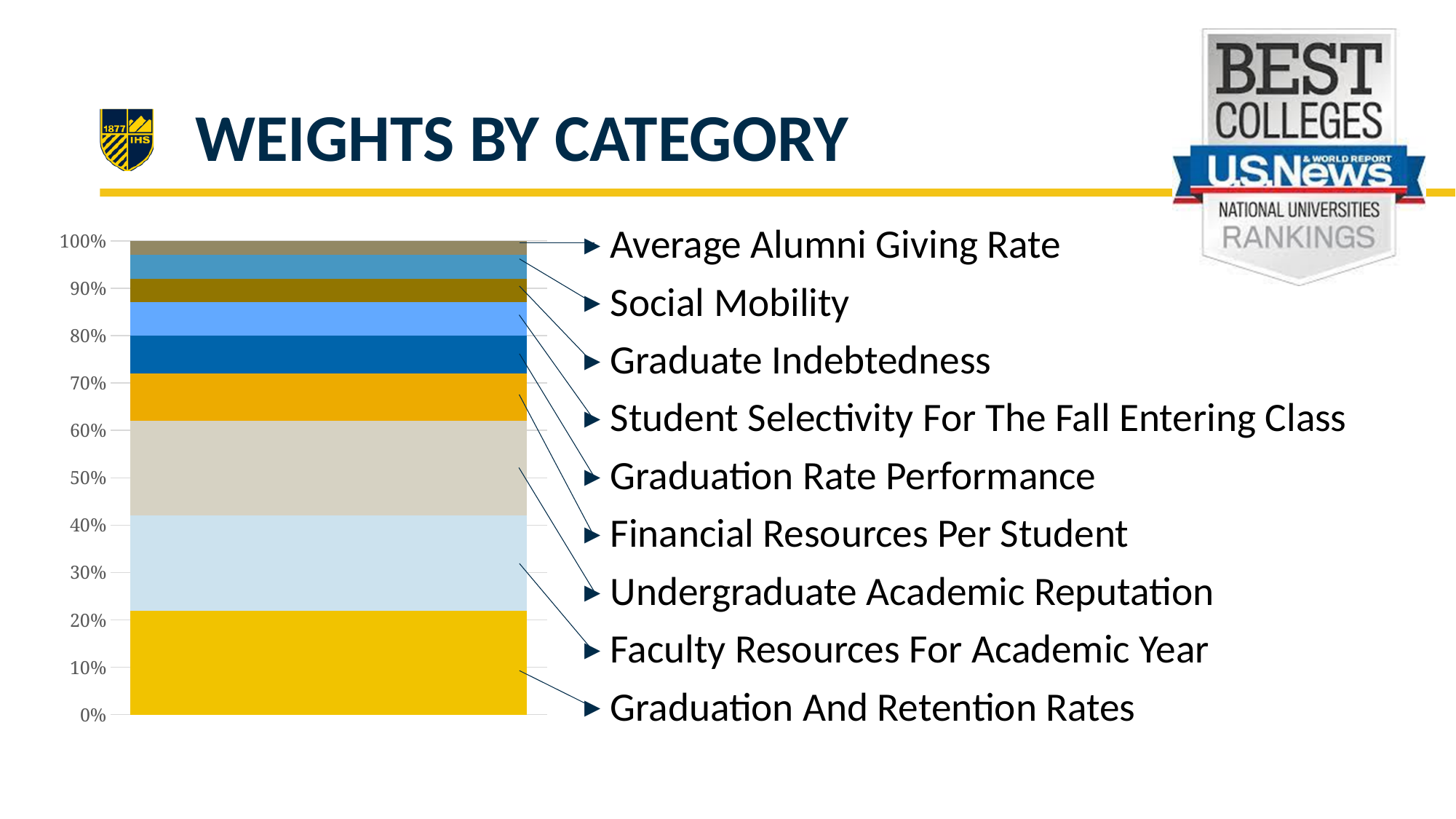
Is the weight for Faculty Resources For Academic Year greater or less than 10%? greater Which category forms the bottom segment of the stacked bar? Graduation And Retention Rates Is the weight for Graduation And Retention Rates greater or less than 10%? greater What kind of chart is shown on the slide? Stacked bar chart Is the weight for Average Alumni Giving Rate greater or less than 10%? less Which category is the smallest segment of the stacked bar? Average Alumni Giving Rate What value does the top of the stacked bar reach on the axis? 100% What is the title of the chart on the slide? WEIGHTS BY CATEGORY Which has the larger weight, Graduation And Retention Rates or Average Alumni Giving Rate? Graduation And Retention Rates How many categories (segments) make up the stacked bar? 9 Which has the larger weight, Undergraduate Academic Reputation or Graduate Indebtedness? Undergraduate Academic Reputation